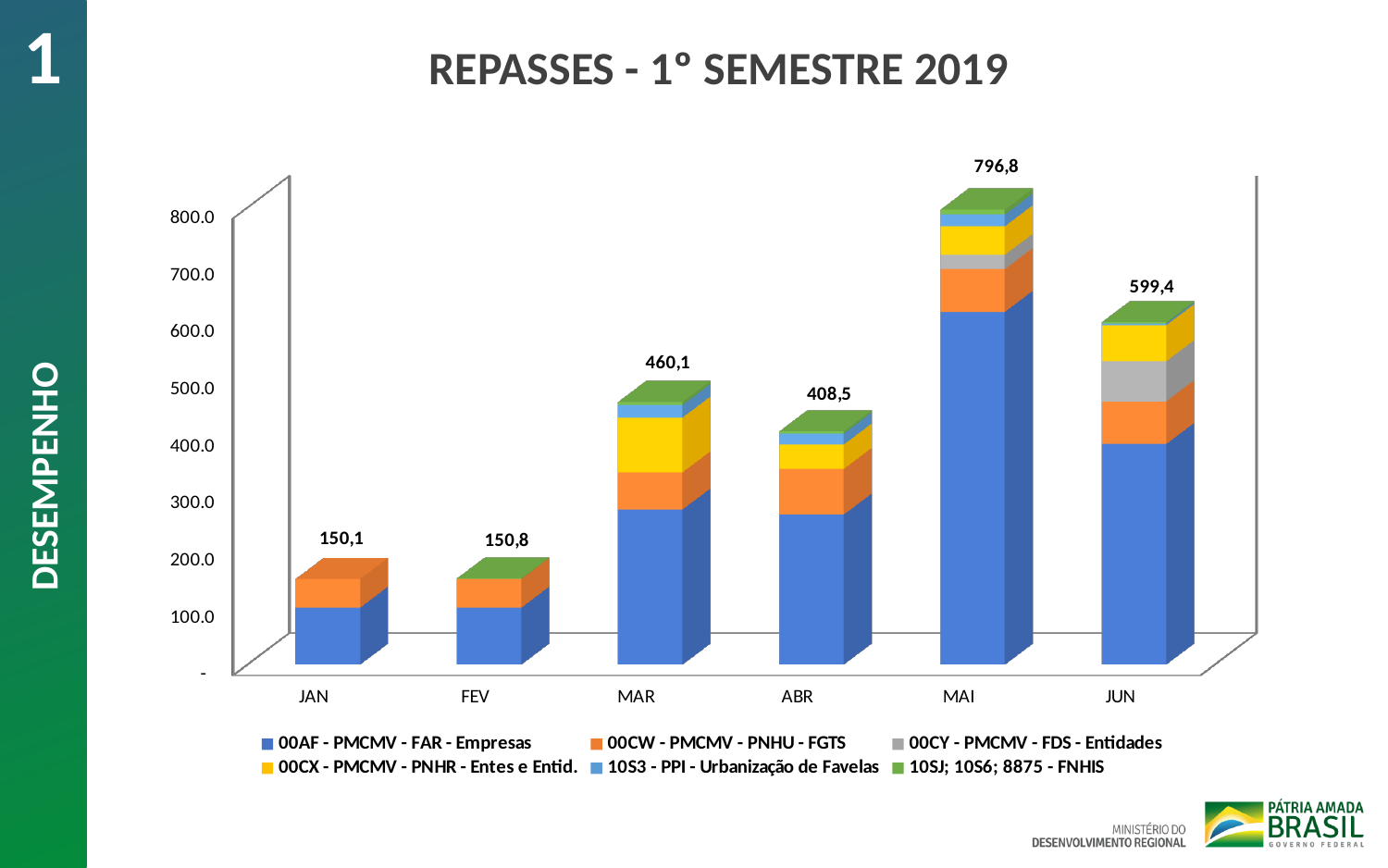
What is the total value shown for JAN? 150,1 What is the difference between the totals for MAR and ABR? 51,6 Which month has the lowest total? JAN How many months are shown on the x axis? 6 What kind of chart is shown on the slide? Stacked bar chart How many series does the legend list? 6 Is the blue 00AF - PMCMV - FAR - Empresas segment for MAI greater or less than 500? greater Which month has the highest total? MAI What is the difference between the totals for MAI and JUN? 197,4 What is the total value shown for MAI? 796,8 What is the total value shown for JUN? 599,4 Which is larger, the total for MAR or the total for ABR? MAR